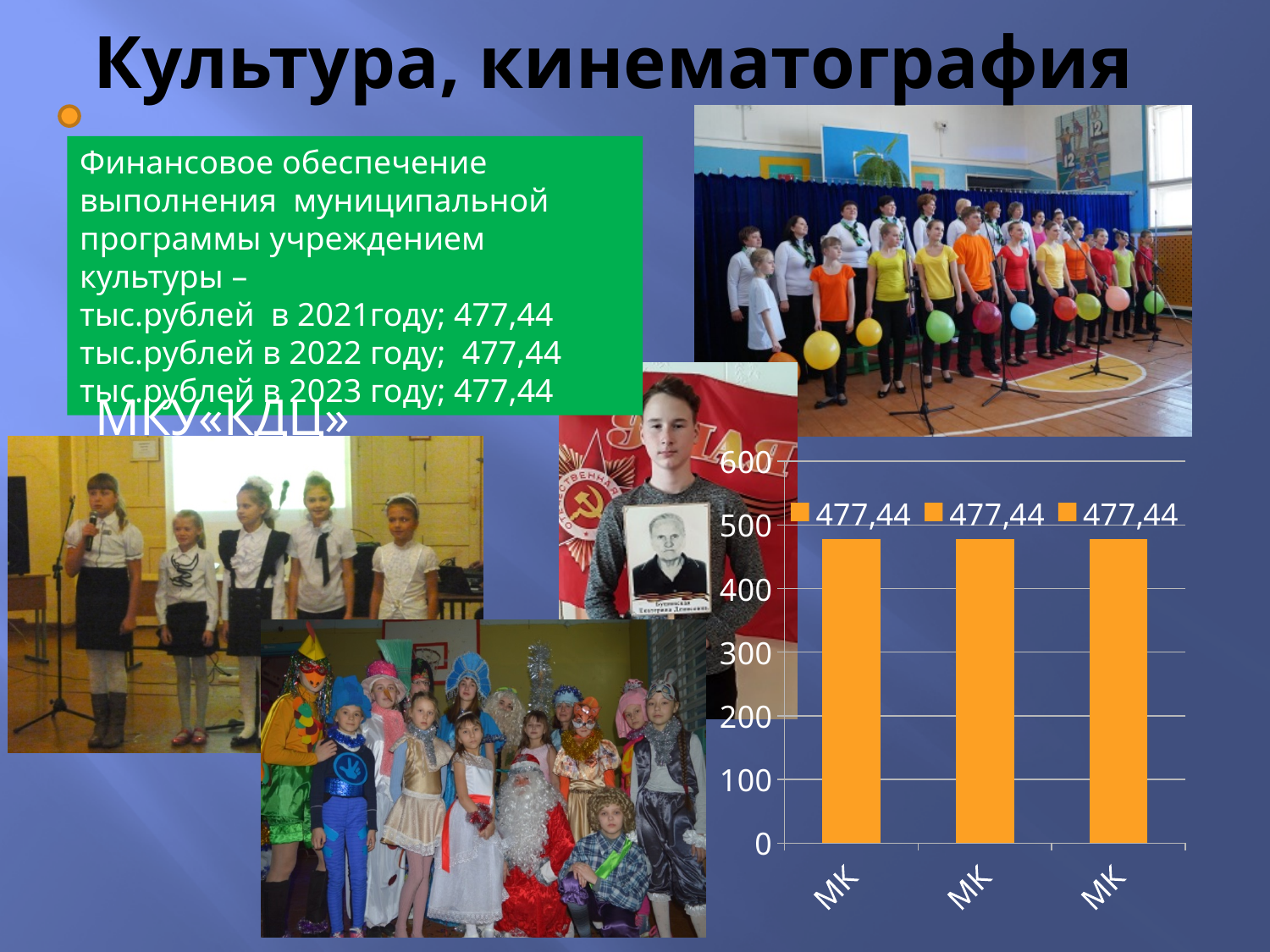
Is the value of the first bar greater or less than 400? greater What label appears under each bar on the x axis? МК Is the value of the second bar greater or less than 500? less What kind of chart is shown on the slide? bar chart What value is shown for each entry in the chart legend? 477,44 What is the highest tick value shown on the y axis? 600 How many bars are plotted in the chart? 3 Is the value of the third bar greater or less than 300? greater Do the bar values rise, fall, or stay the same from left to right? stay the same